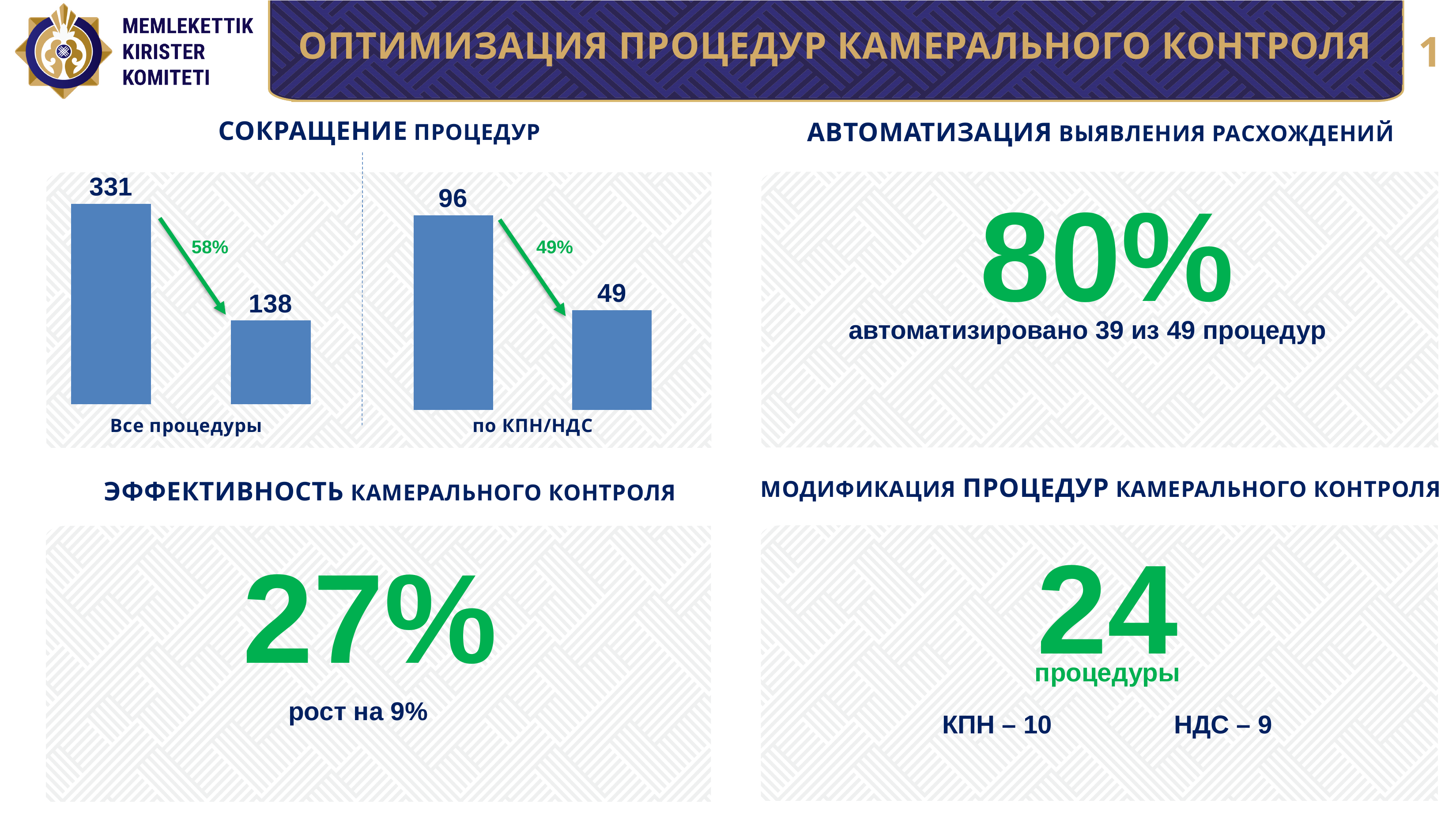
How many bars are shown in the 'по КПН/НДС' chart? 2 In the 'Все процедуры' chart, what is the difference between the first bar (331) and the second bar (138)? 193 In the 'Все процедуры' chart under 'СОКРАЩЕНИЕ ПРОЦЕДУР', what is the value of the shorter (second) bar? 138 In the 'Все процедуры' chart, what percentage reduction is shown next to the arrow? 58% What type of chart is used under 'СОКРАЩЕНИЕ ПРОЦЕДУР'? Bar chart In the 'по КПН/НДС' chart, what is the difference between the first bar (96) and the second bar (49)? 47 In the 'по КПН/НДС' chart under 'СОКРАЩЕНИЕ ПРОЦЕДУР', what is the value of the second bar? 49 Which is larger: the first bar of the 'Все процедуры' chart or the first bar of the 'по КПН/НДС' chart? Все процедуры (331) In the 'Все процедуры' chart under 'СОКРАЩЕНИЕ ПРОЦЕДУР', what is the value of the taller (first) bar? 331 In the 'по КПН/НДС' chart under 'СОКРАЩЕНИЕ ПРОЦЕДУР', what is the value of the first bar? 96 In the 'Все процедуры' chart, do the values rise or fall from the first bar to the second bar? Fall In the 'по КПН/НДС' chart, what percentage reduction is shown next to the arrow? 49%